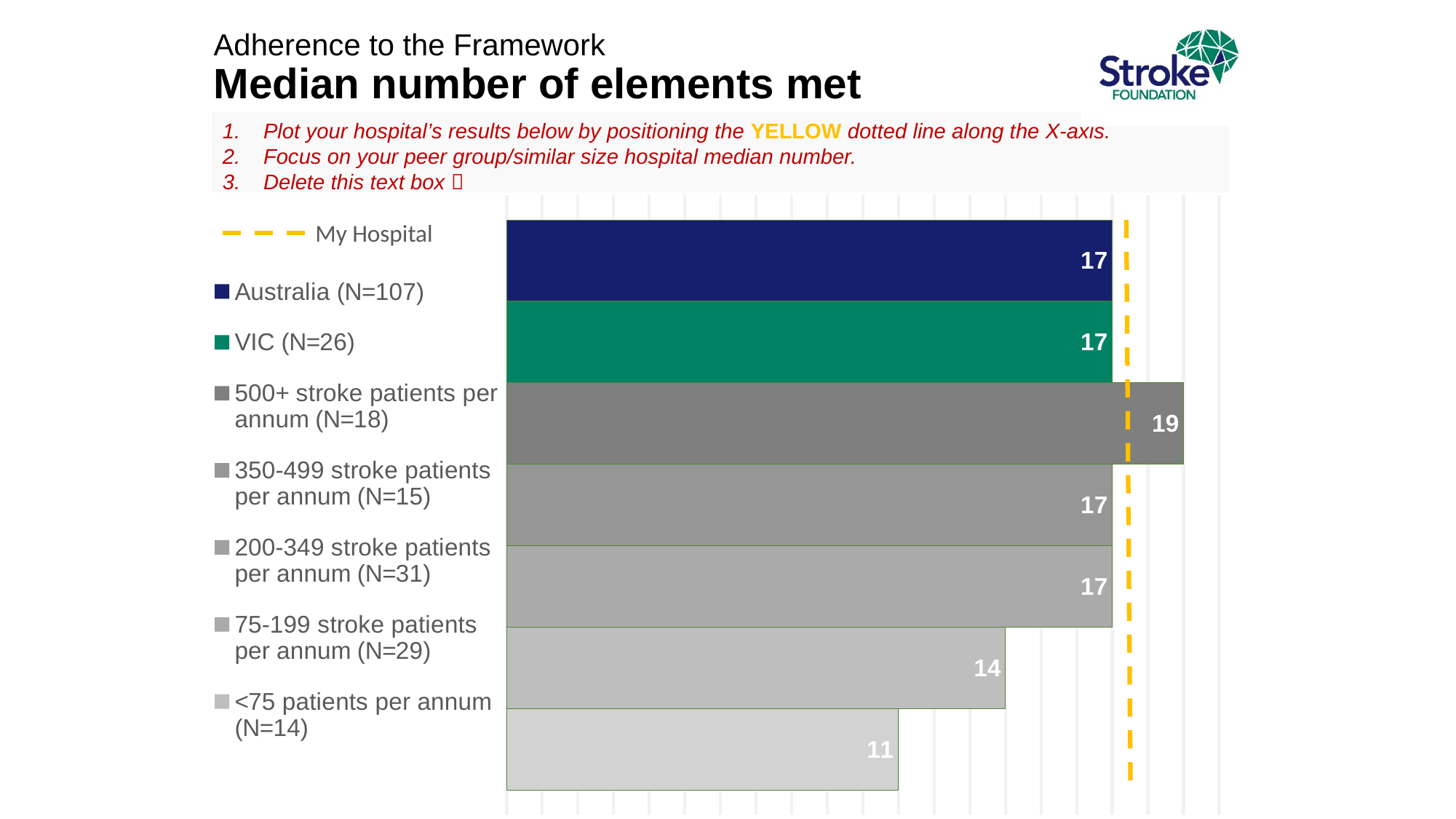
How many bars are plotted in the chart? 7 What is the difference between the median number of elements met for 500+ stroke patients per annum and <75 patients per annum? 8 What is the median number of elements met for VIC (N=26)? 17 Which group has the lowest median number of elements met? <75 patients per annum (N=14) What is the median number of elements met for Australia (N=107)? 17 What type of chart is shown on the slide? Bar chart Which group has the highest median number of elements met? 500+ stroke patients per annum (N=18) What is the median number of elements met for hospitals with 75-199 stroke patients per annum (N=29)? 14 Which is larger: the median for 75-199 stroke patients per annum or for 200-349 stroke patients per annum? 200-349 stroke patients per annum What is the median number of elements met for hospitals with 500+ stroke patients per annum (N=18)? 19 What is the median number of elements met for hospitals with <75 patients per annum (N=14)? 11 What does the yellow dotted line in the legend represent? My Hospital